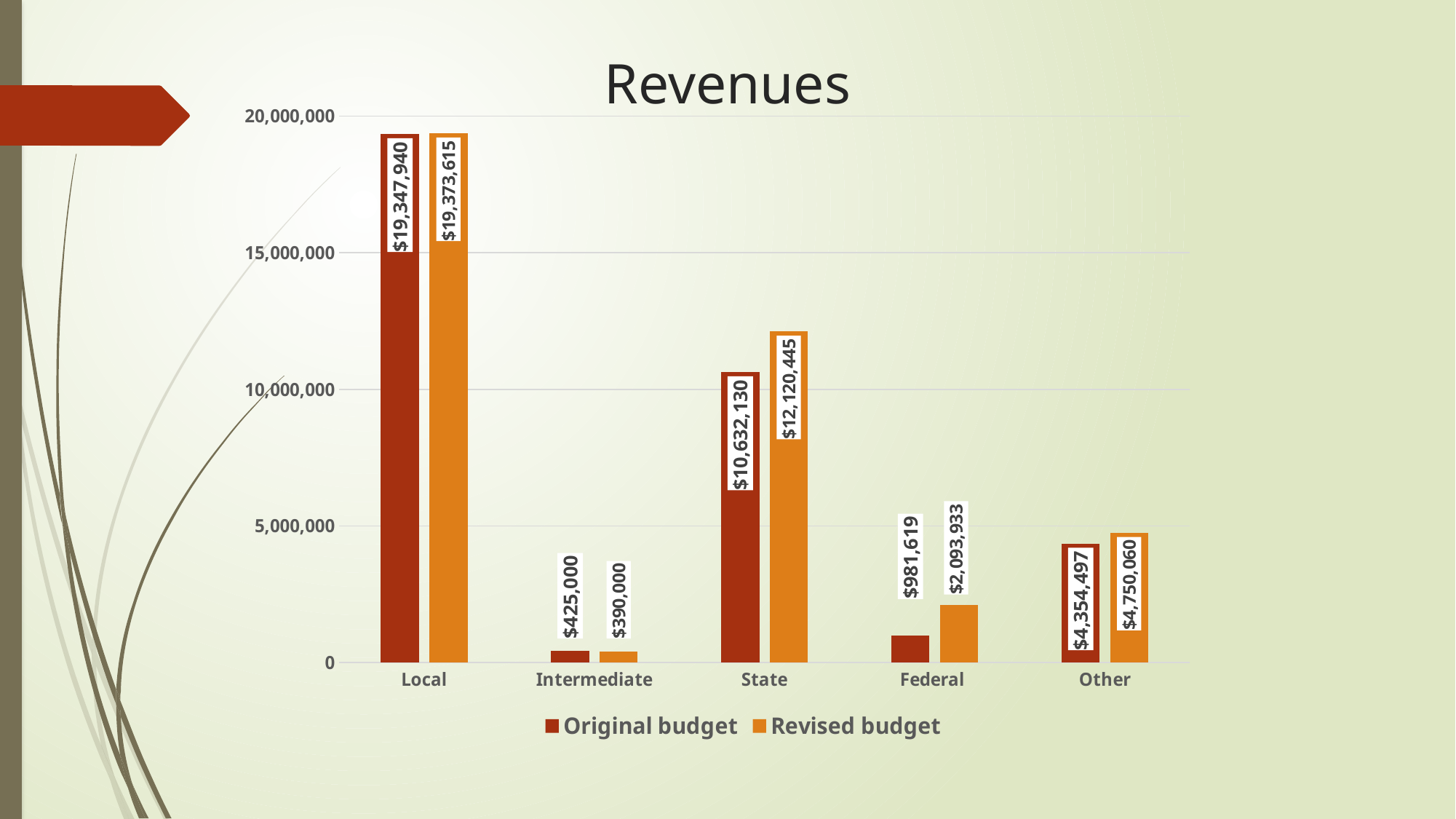
Is the Revised budget value for Other greater or less than 5,000,000? less What is the Revised budget value for Federal? $2,093,933 What is the difference between the Original budget and Revised budget values for Intermediate? $35,000 Which category has the lowest Original budget value? Intermediate What is the Revised budget value for Intermediate? $390,000 What is the Original budget value for State? $10,632,130 How many series does the legend list? 2 What kind of chart is shown on the slide? bar chart Which category has the highest Revised budget value? Local How many categories are shown on the x axis? 5 For Federal, which is larger: the Original budget or the Revised budget? Revised budget What is the difference between the Revised budget and Original budget values for State? $1,488,315